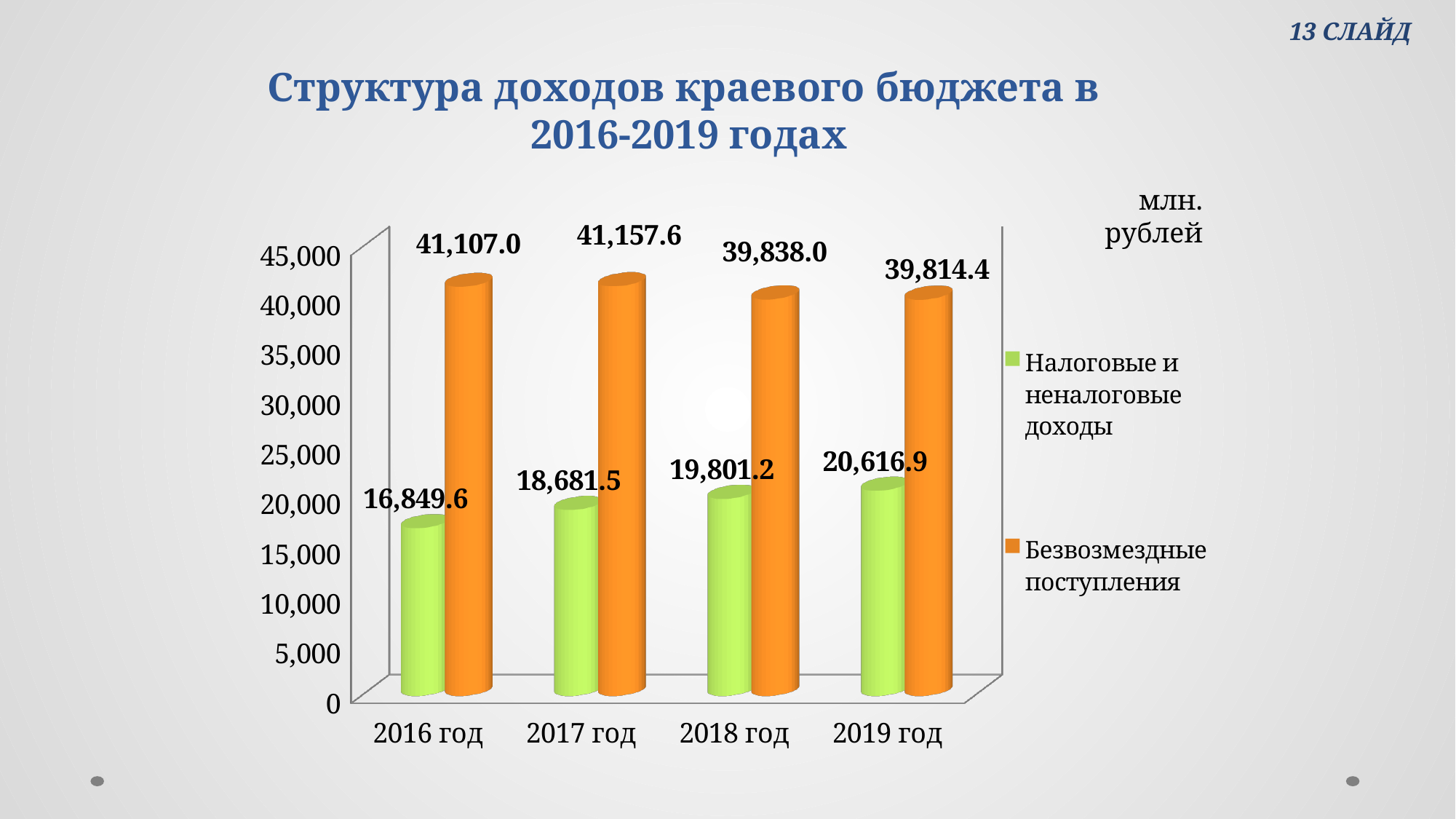
What is the value for Безвозмездные поступления in 2018 год? 39,838.0 How many years are shown on the x axis? 4 How many series does the legend list? 2 What is the difference between Безвозмездные поступления and Налоговые и неналоговые доходы in 2019 год? 19,197.5 What is the value for Налоговые и неналоговые доходы in 2019 год? 20,616.9 What is the value for Налоговые и неналоговые доходы in 2016 год? 16,849.6 In which year is Налоговые и неналоговые доходы lowest? 2016 год By how much did Налоговые и неналоговые доходы increase from 2016 год to 2019 год? 3,767.3 Which is larger in 2017 год: Налоговые и неналоговые доходы or Безвозмездные поступления? Безвозмездные поступления Do the values for Налоговые и неналоговые доходы rise or fall from 2016 год to 2019 год? Rise In which year is Безвозмездные поступления highest? 2017 год What kind of chart is shown on the slide? Bar chart